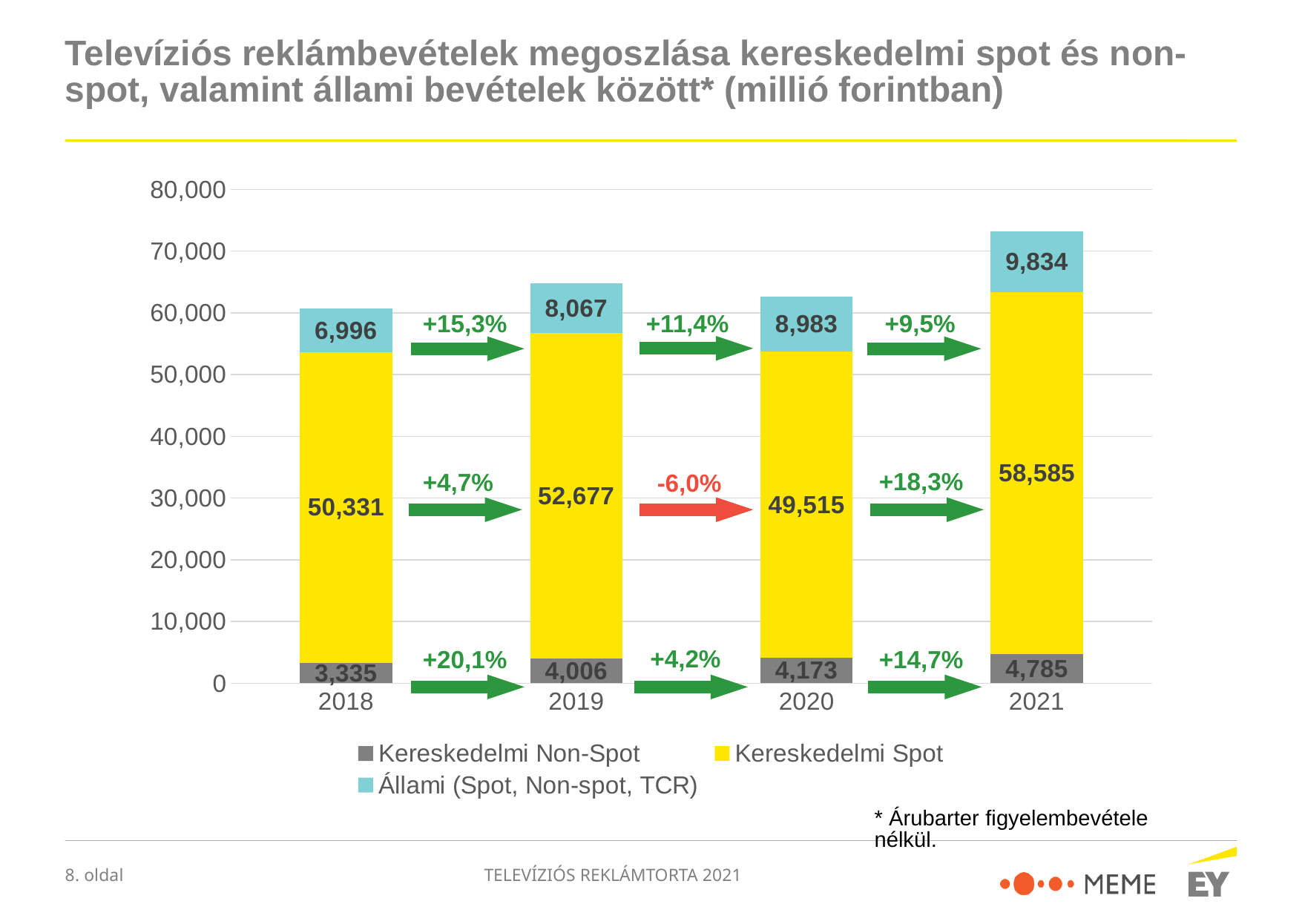
How many series does the legend list? 3 What is the Kereskedelmi Spot value for 2020? 49,515 Which is larger, the Állami value for 2019 or for 2020? 2020 In which year is the Kereskedelmi Spot value highest? 2021 What is the Kereskedelmi Non-Spot value for 2018? 3,335 In which year is the Kereskedelmi Non-Spot value lowest? 2018 How many years are shown on the x axis? 4 What is the total of the stacked bar for 2021? 73,204 What kind of chart is shown on the slide? Stacked bar chart What is the total of the stacked bar for 2018? 60,662 What is the difference between the Kereskedelmi Spot values for 2021 and 2020? 9,070 What is the Állami (Spot, Non-spot, TCR) value for 2021? 9,834